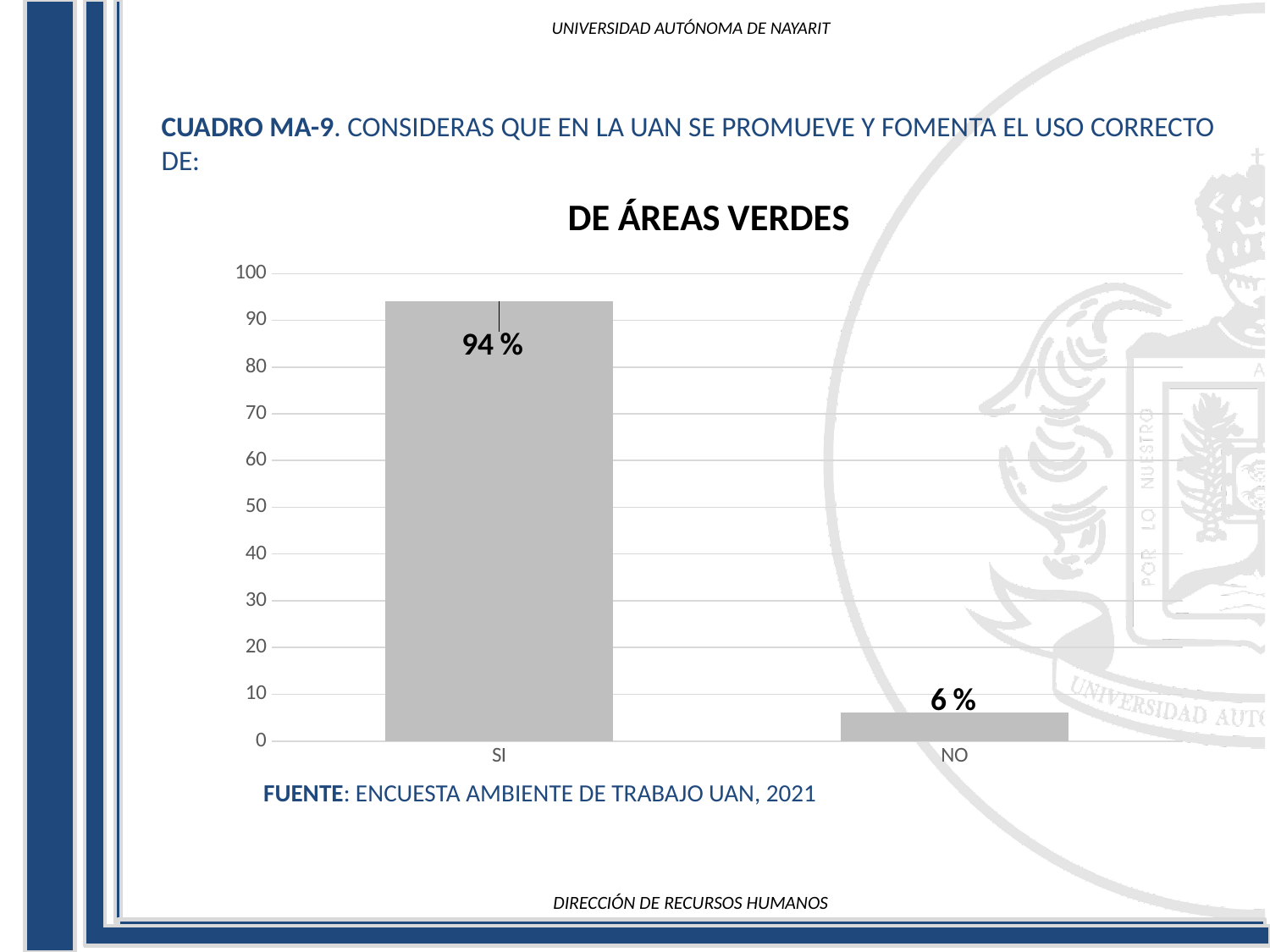
Is the value for SI greater or less than 90? greater Is the value for NO greater or less than 10? less Which is larger, the value for SI or the value for NO? SI What kind of chart is shown? bar chart How many categories are shown on the x axis? 2 What is the title of the chart? DE ÁREAS VERDES What is the difference between the values for SI and NO? 88 % What is the value for SI? 94 % What is the maximum value shown on the vertical axis? 100 Which category has the lowest value? NO Which category has the highest value? SI What is the value for NO? 6 %